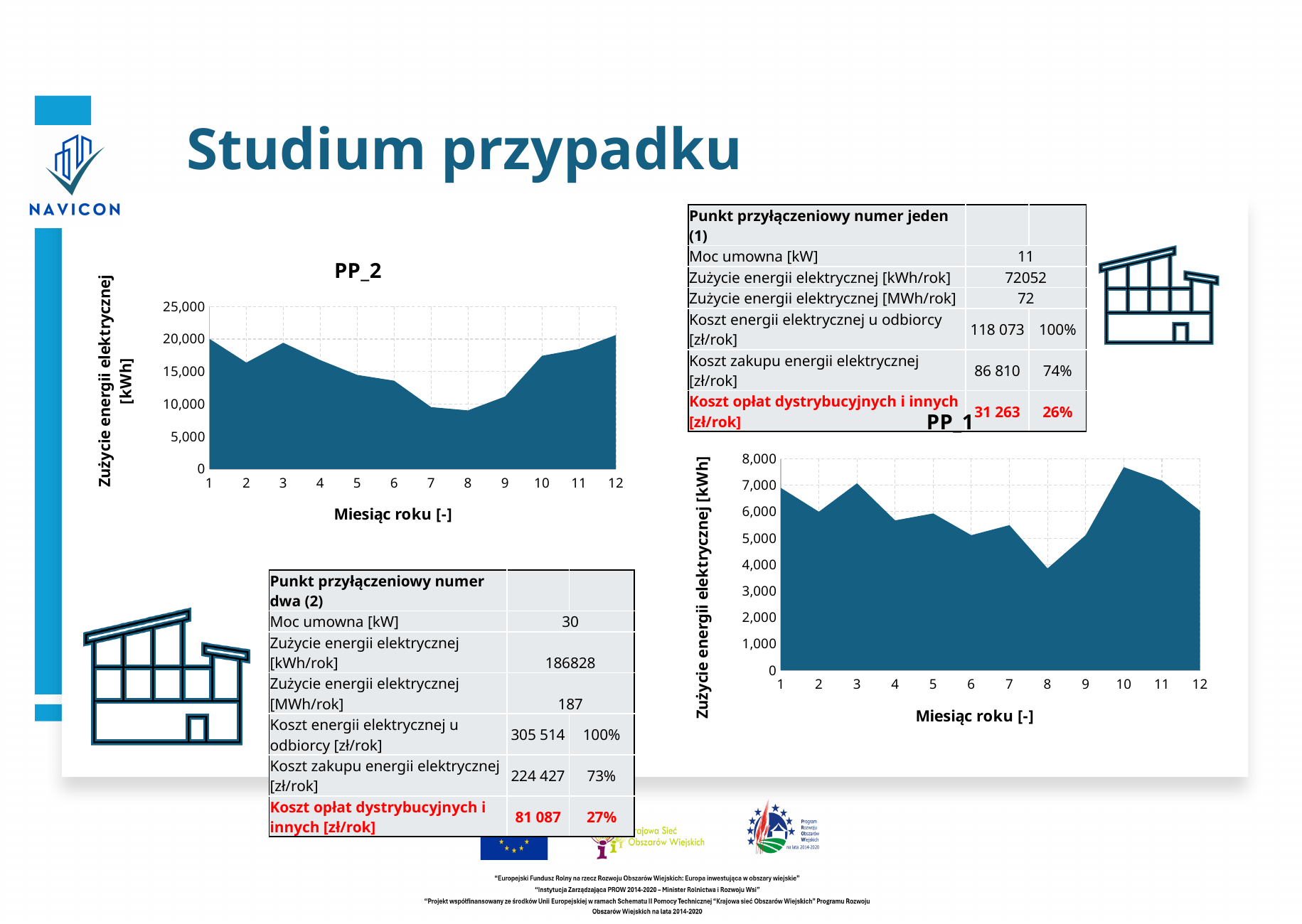
In the PP_1 chart, which month has the larger value, month 1 or month 9? 1 In the PP_1 chart, is the value for month 8 greater or less than 5,000? less What is the x-axis title of the PP_1 chart? Miesiąc roku [-] How many months are plotted on the x axis of the PP_1 chart? 12 In the PP_2 chart, is the value for month 1 greater or less than 15,000? greater In the PP_1 chart, which month has the highest electricity consumption? 10 In the PP_1 chart, is the value for month 10 greater or less than 7,000? greater In the PP_2 chart, which month has the larger value, month 3 or month 7? 3 In the PP_2 chart, do the values rise or fall from month 8 to month 12? rise What kind of chart is the PP_2 chart? area chart In the PP_1 chart, which month has the lowest electricity consumption? 8